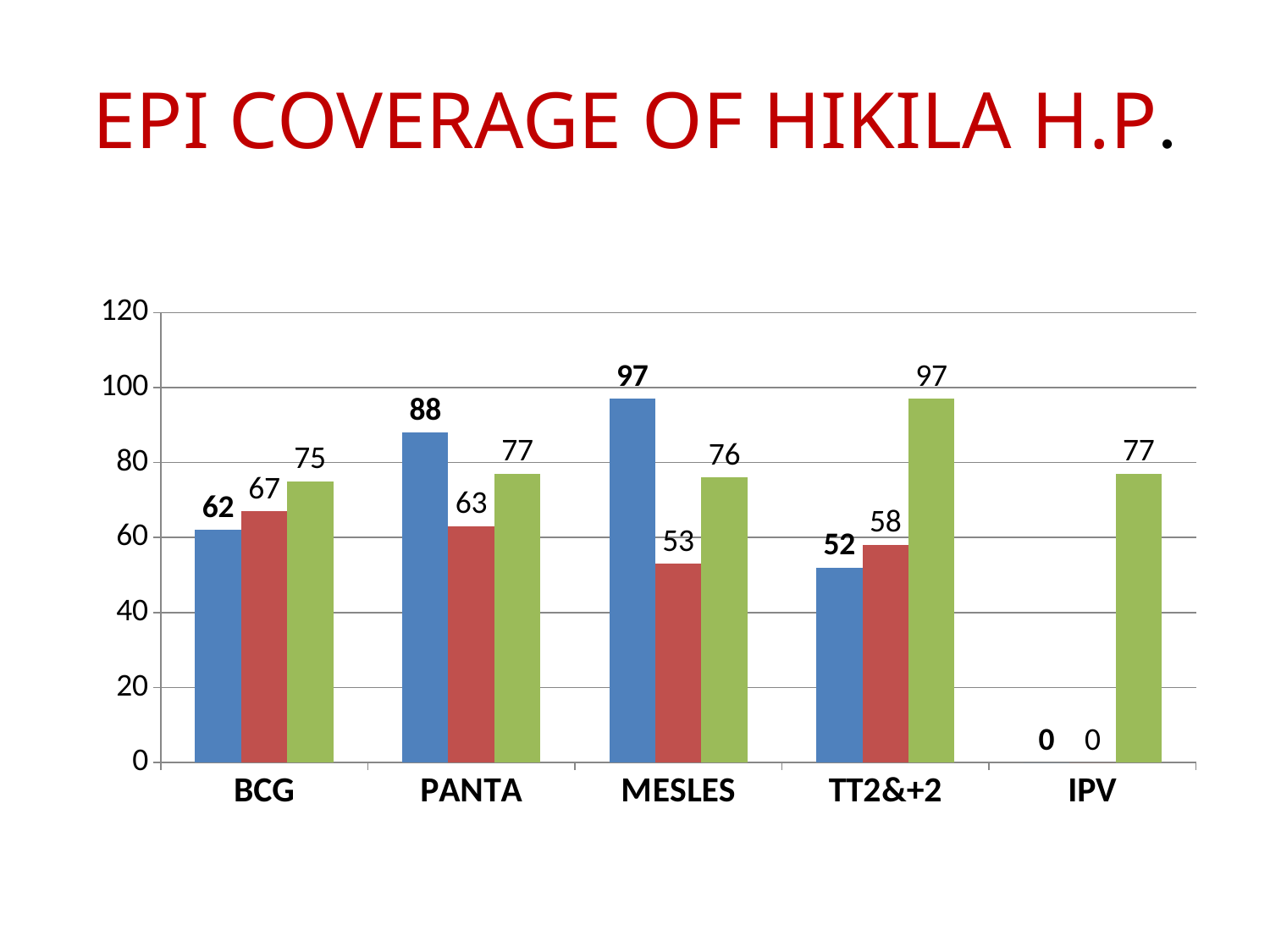
Which category has the highest blue bar? MESLES What is the value of the blue bar for TT2&+2? 52 What is the value of the green bar for IPV? 77 What is the title of the slide? EPI COVERAGE OF HIKILA H.P. Which category has the lowest red bar? IPV What is the difference between the blue bar and the red bar for MESLES? 44 Which is larger for BCG, the blue bar or the red bar? the red bar How many categories are shown on the x axis? 5 What is the difference between the green bar for TT2&+2 and the green bar for BCG? 22 What is the value of the red bar for PANTA? 63 What type of chart is shown on the slide? bar chart What is the value of the blue bar for MESLES? 97